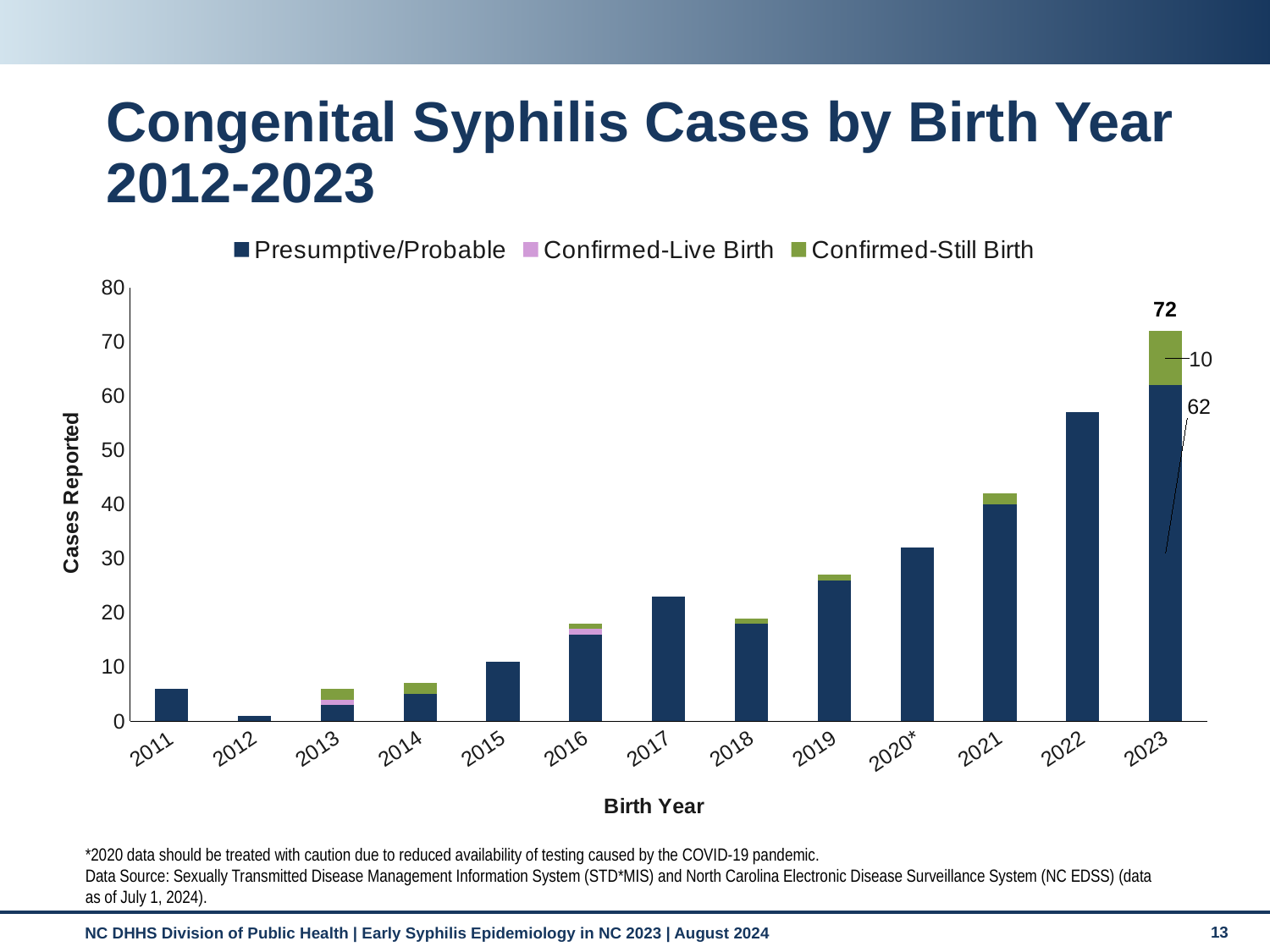
Is the total value for birth year 2022 greater or less than 50? greater What is the difference between the Presumptive/Probable and Confirmed-Still Birth values for 2023? 52 How many Confirmed-Still Birth cases are shown for birth year 2023? 10 Which birth year has more cases reported, 2019 or 2021? 2021 How many series does the legend list? 3 What is the total number of cases reported for birth year 2023? 72 What is the title of the x axis? Birth Year How many birth years are shown on the x axis? 13 Which birth year has the highest total number of cases reported? 2023 How many Presumptive/Probable cases are shown for birth year 2023? 62 Which birth year has the lowest total number of cases reported? 2012 What kind of chart is shown on the slide? Bar chart